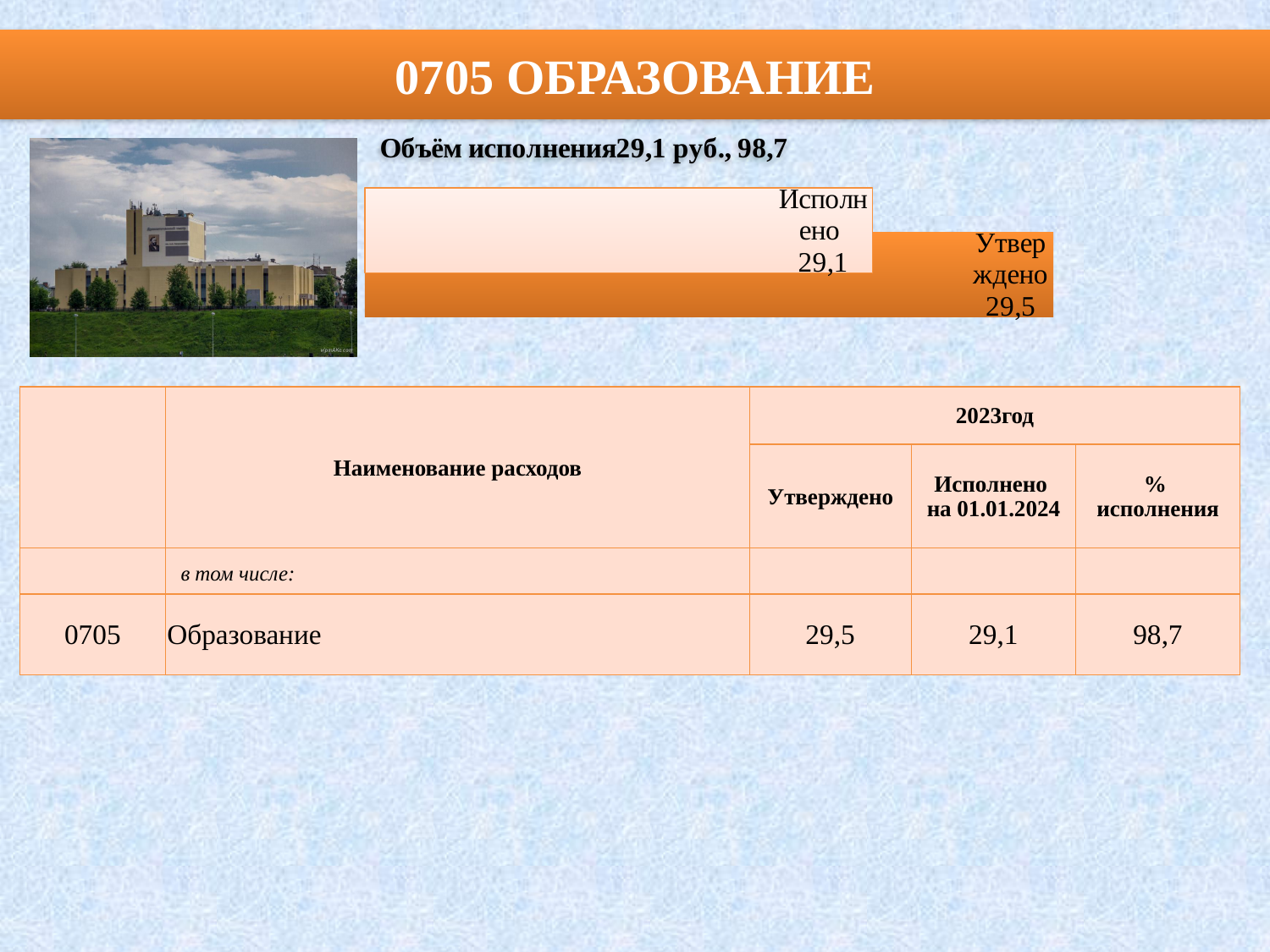
What is the title shown in the banner at the top of the slide? 0705 ОБРАЗОВАНИЕ What kind of chart is shown on the slide? bar chart Which bar has the higher value, Исполнено or Утверждено? Утверждено Which bar shows the smallest value? Исполнено Which bar shows the largest value? Утверждено What is the value of the bar labelled Утверждено? 29,5 What colour is the bar labelled Утверждено? orange How many bars are plotted in the chart? 2 What is the difference between the Утверждено value and the Исполнено value? 0,4 What is the value of the bar labelled Исполнено? 29,1